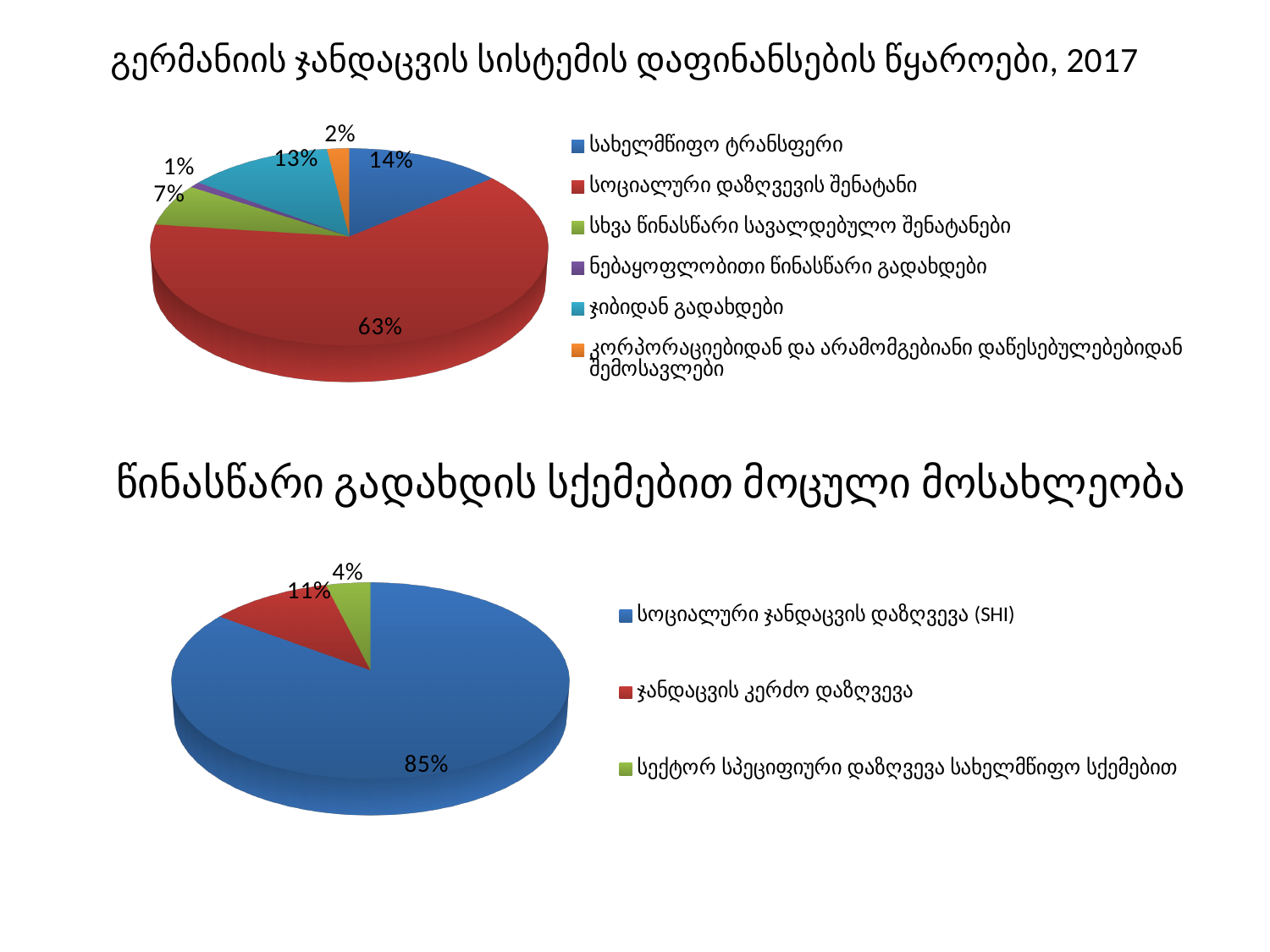
In the top chart, which category has the largest slice? სოციალური დაზღვევის შენატანი How many categories does the legend of the top chart list? 6 In the bottom chart, which category has the smallest slice? სექტორ სპეციფიური დაზღვევა სახელმწიფო სქემებით In the top chart, what is the difference in percentage points between სოციალური დაზღვევის შენატანი and სახელმწიფო ტრანსფერი? 49 percentage points In the bottom chart, what share is labelled for ჯანდაცვის კერძო დაზღვევა? 11% In the top chart, which category has the smallest slice? ნებაყოფლობითი წინასწარი გადახდები In the top chart, what share is labelled for ჯიბიდან გადახდები? 13% In the top chart, what share is labelled for სახელმწიფო ტრანსფერი? 14% What type of chart is the bottom chart (წინასწარი გადახდის სქემებით მოცული მოსახლეობა)? Pie chart In the bottom chart, what share is labelled for სოციალური ჯანდაცვის დაზღვევა (SHI)? 85% In the top chart (გერმანიის ჯანდაცვის სისტემის დაფინანსების წყაროები, 2017), what share is labelled for სოციალური დაზღვევის შენატანი? 63% In the top chart, which is larger: სახელმწიფო ტრანსფერი or ჯიბიდან გადახდები? სახელმწიფო ტრანსფერი